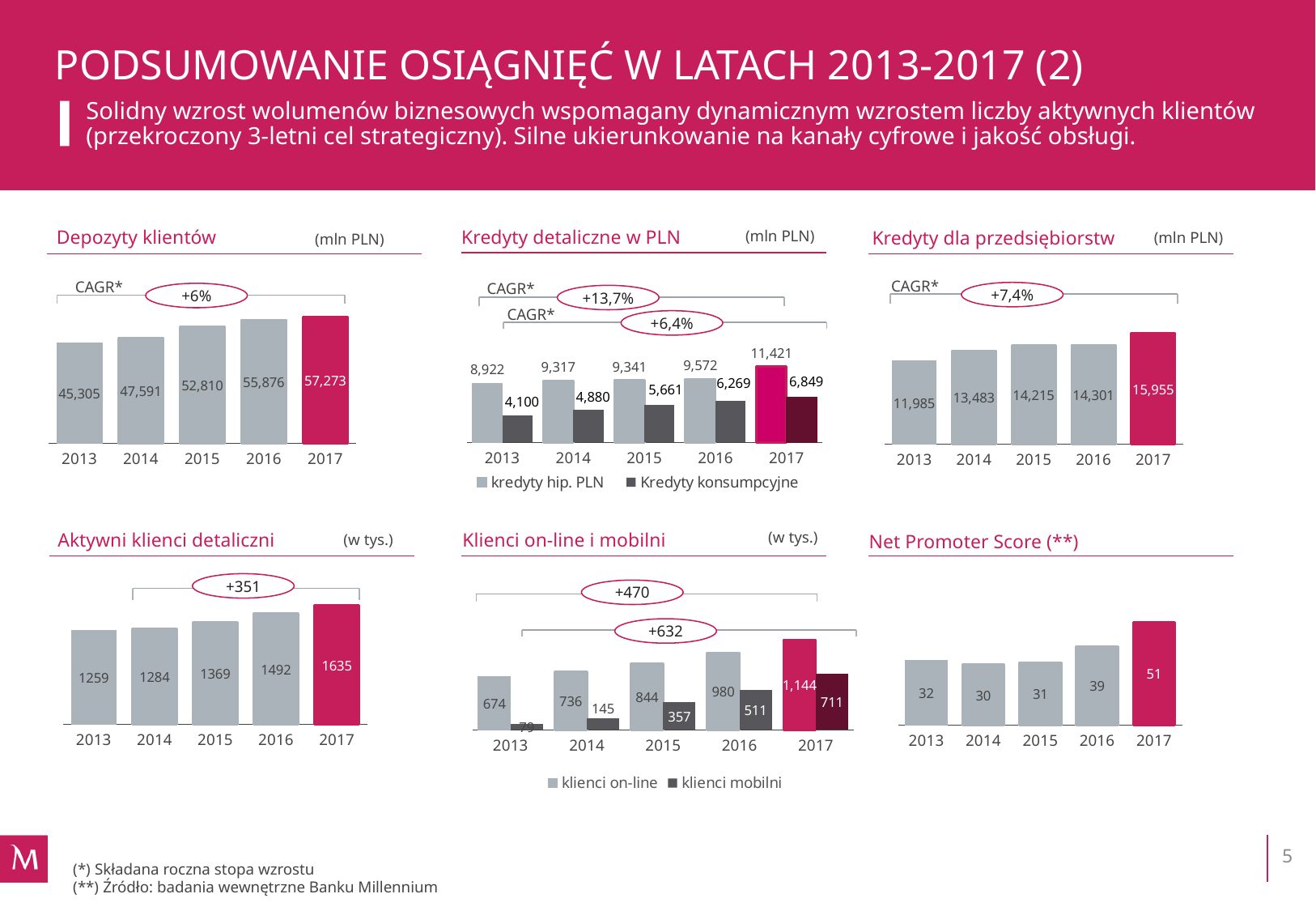
In the 'Aktywni klienci detaliczni' chart, what is the value for 2016? 1492 In the 'Depozyty klientów' chart, what is the value for 2015? 52,810 In the 'Klienci on-line i mobilni' chart, what is the value of 'klienci mobilni' for 2015? 357 In the 'Kredyty detaliczne w PLN' chart, which is larger in 2017: 'kredyty hip. PLN' or 'Kredyty konsumpcyjne'? kredyty hip. PLN In the 'Depozyty klientów' chart, what is the difference between the 2017 and 2013 values? 11,968 What kind of chart is the 'Net Promoter Score (**)' chart? bar chart In the 'Kredyty detaliczne w PLN' chart, how many series does the legend list? 2 In the 'Aktywni klienci detaliczni' chart, do the values rise or fall from 2013 to 2017? rise In the 'Kredyty detaliczne w PLN' chart, what is the value of 'Kredyty konsumpcyjne' for 2016? 6,269 In the 'Net Promoter Score (**)' chart, which year has the highest value? 2017 In the 'Kredyty dla przedsiębiorstw' chart, what CAGR is shown? +7,4% In the 'Kredyty dla przedsiębiorstw' chart, which year has the lowest value? 2013